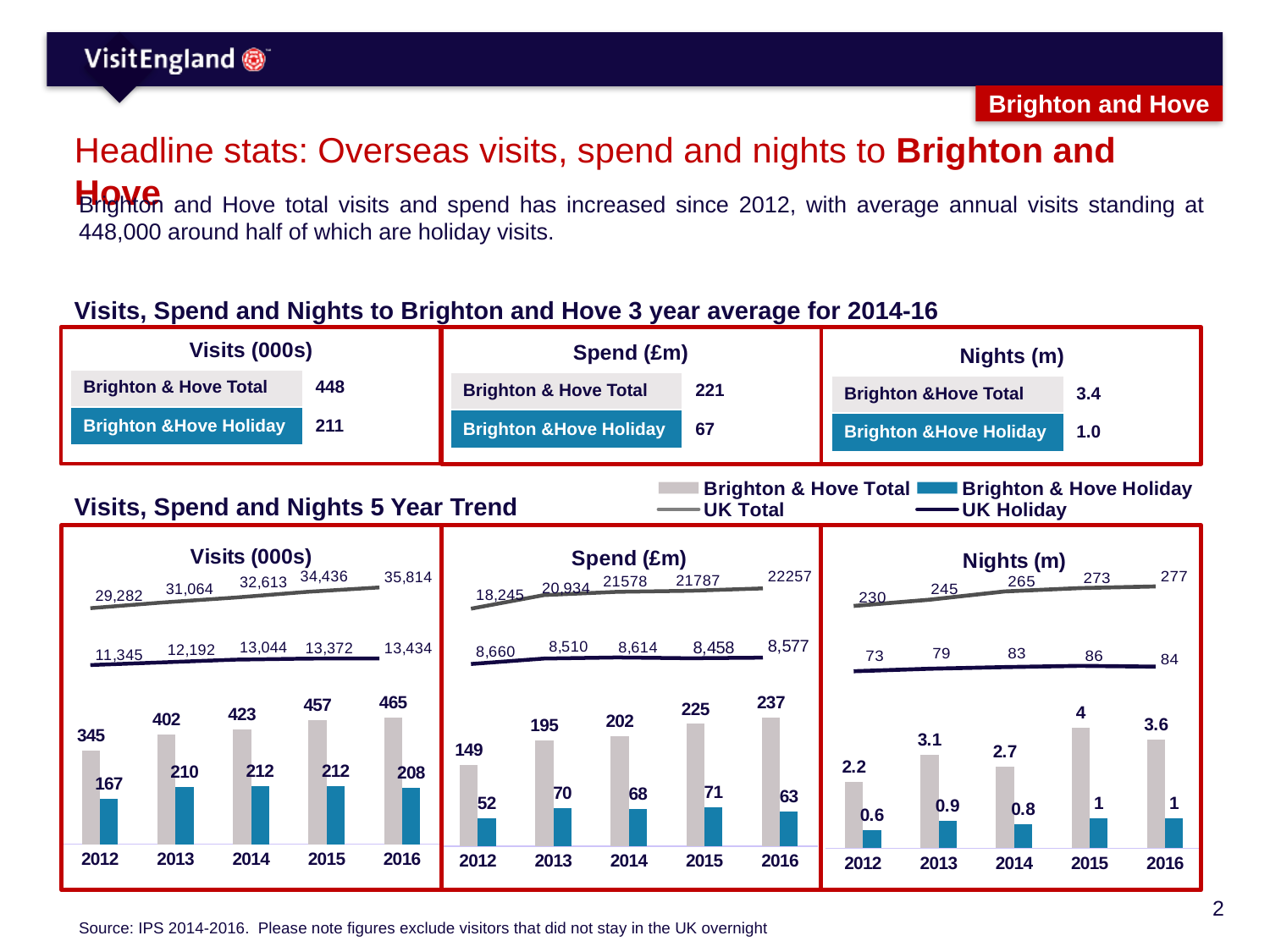
In the Spend (£m) chart, what is the Brighton & Hove Total value for 2015? 225 How many years are shown on the x axis of the Visits (000s) chart? 5 In the Spend (£m) chart, which year has the lowest Brighton & Hove Holiday value? 2012 In the Visits (000s) chart, do the Brighton & Hove Total values rise or fall from 2012 to 2016? rise In the Visits (000s) chart, what is the Brighton & Hove Holiday value for 2012? 167 In the Visits (000s) chart, what is the difference between the Brighton & Hove Total values for 2016 and 2012? 120 How many series does the shared legend above the 5 Year Trend charts list? 4 In the Spend (£m) chart, is the Brighton & Hove Holiday value for 2013 larger or smaller than for 2014? larger In the Nights (m) chart, which year has the highest Brighton & Hove Total value? 2015 In the Nights (m) chart, what is the Brighton & Hove Holiday value for 2013? 0.9 In the Visits (000s) chart, what is the Brighton & Hove Total value for 2016? 465 In the Spend (£m) chart, what is the UK Total value for 2016? 22257